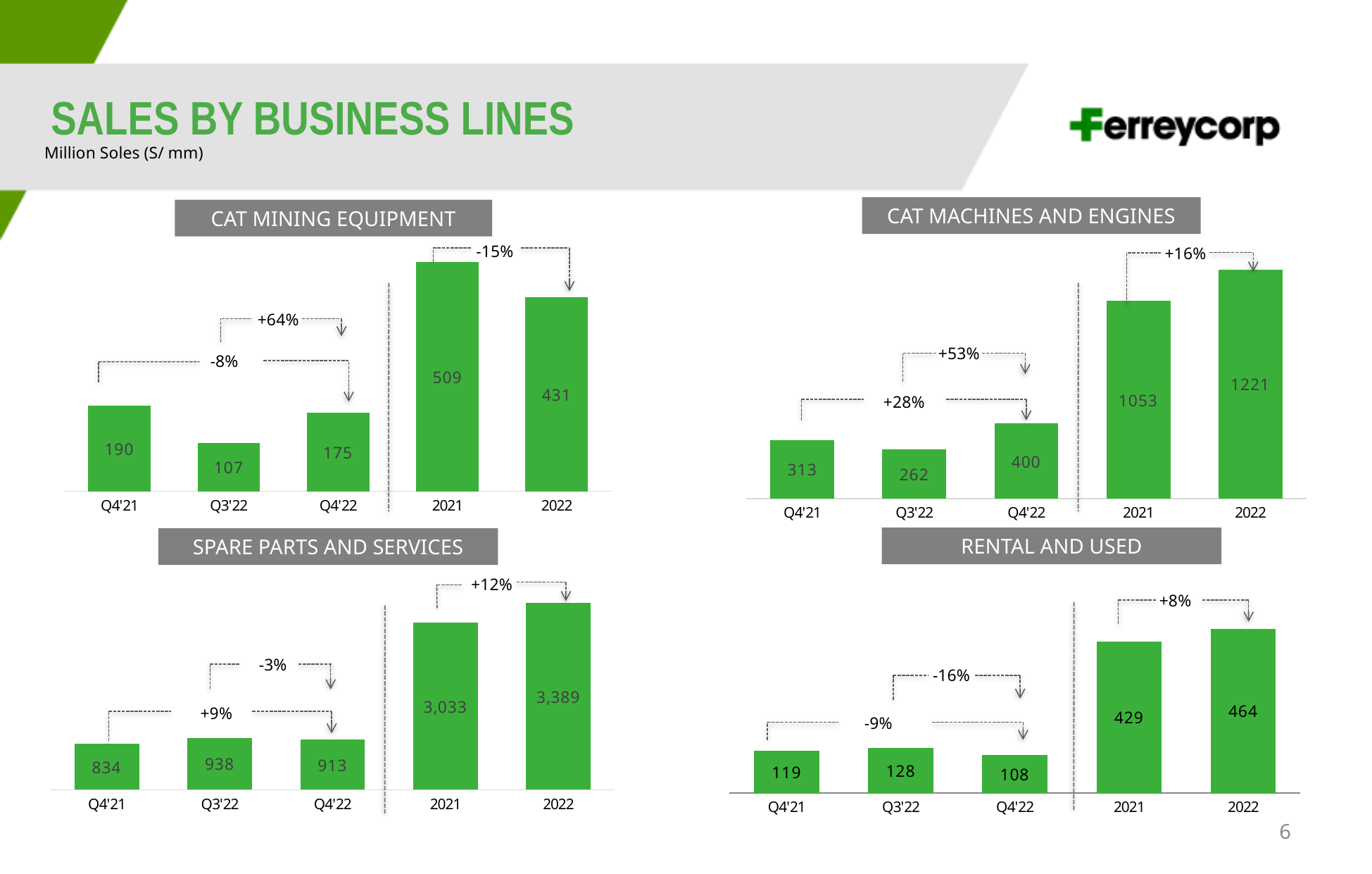
In the CAT MINING EQUIPMENT chart, what is the value for Q3'22? 107 In the SPARE PARTS AND SERVICES chart, what is the value for 2021? 3,033 In the RENTAL AND USED chart, which category has the lowest value? Q4'22 How many bars are plotted in the RENTAL AND USED chart? 5 What kind of chart is the CAT MINING EQUIPMENT chart? Bar chart In the CAT MACHINES AND ENGINES chart, what is the difference between the 2022 and 2021 values? 168 In the SPARE PARTS AND SERVICES chart, which is larger, the value for Q3'22 or the value for Q4'22? Q3'22 In the RENTAL AND USED chart, what is the value for Q4'22? 108 In the CAT MINING EQUIPMENT chart, what is the difference between the Q4'21 and Q4'22 values? 15 In the CAT MACHINES AND ENGINES chart, what percentage change is shown between 2021 and 2022? +16% In the CAT MINING EQUIPMENT chart, which category has the highest value? 2021 In the CAT MACHINES AND ENGINES chart, what is the value for 2022? 1221